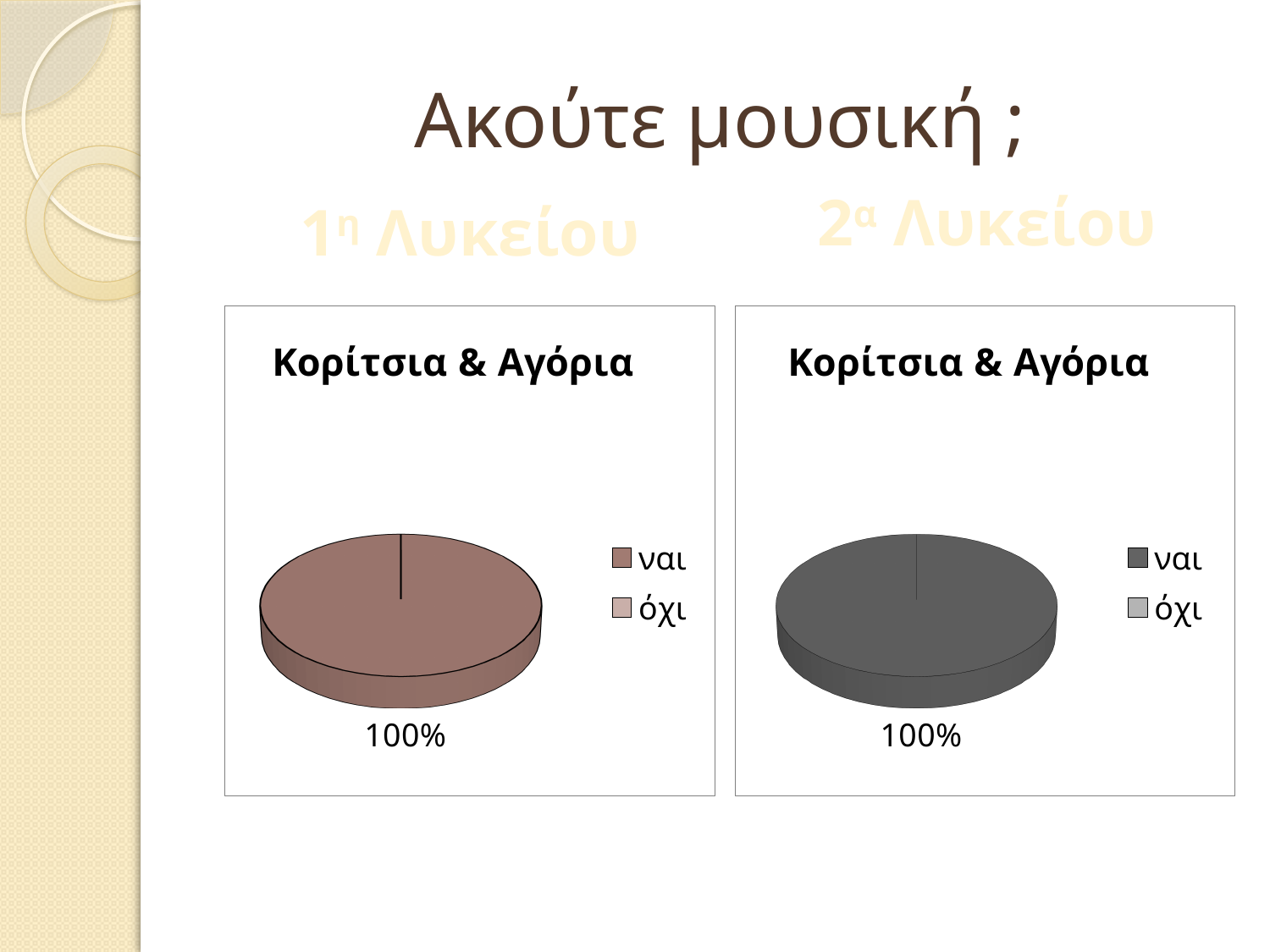
In the right pie chart, which category has the largest slice? ναι In the left pie chart, is the share for 'ναι' larger or smaller than the share for 'όχι'? larger How many entries does the legend of the right pie chart list? 2 What is the title of the left pie chart? Κορίτσια & Αγόρια What kind of chart is the left chart on the slide? pie chart What are the two legend entries of the right pie chart? ναι, όχι In the left pie chart, what share of the pie does the 'ναι' slice take? 100% In the left pie chart, which category has the largest slice? ναι In the right pie chart, what share of the pie does the 'ναι' slice take? 100% What kind of chart is the right chart on the slide? pie chart How many entries does the legend of the left pie chart list? 2